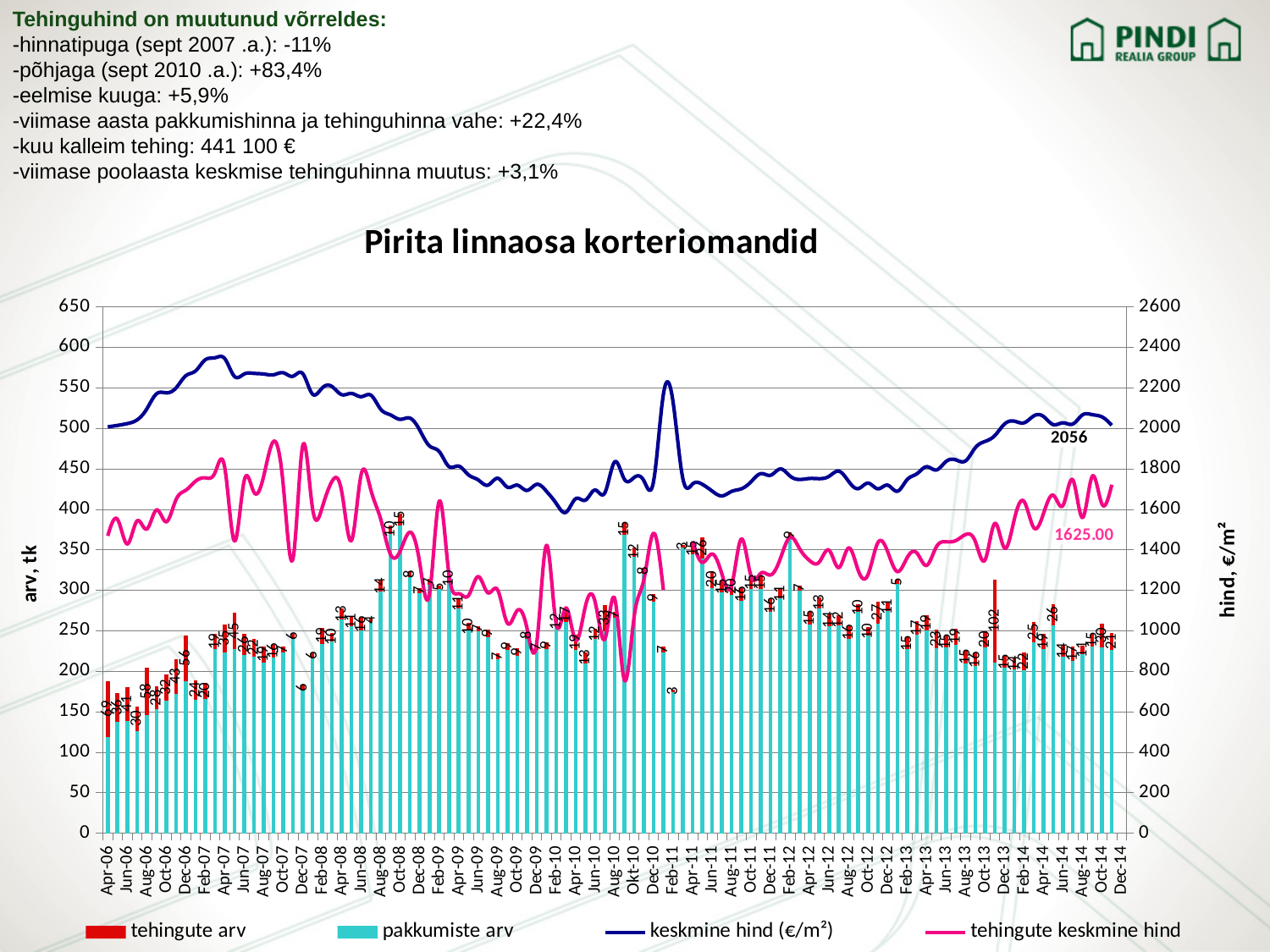
Is the keskmine hind (€/m²) value around Feb-07 greater or less than 2200? greater What is the last labelled value of the tehingute keskmine hind line? 1625.00 Is the tehingute keskmine hind value at its dip around Okt-10 greater or less than 1000? less How many series does the chart legend list? 4 What is the difference between the labelled end values of keskmine hind (2056) and tehingute keskmine hind (1625.00)? 431 What kind of chart is this? Combined bar and line chart At the end of the chart, which is higher: keskmine hind (€/m²) or tehingute keskmine hind? keskmine hind (€/m²) Is the pakkumiste arv bar at Apr-06 greater or less than 200? less Does the keskmine hind (€/m²) line rise or fall from Apr-06 to Feb-07? rise What is the label of the right-hand vertical axis? hind, €/m² What is the title of the chart? Pirita linnaosa korteriomandid What is the last labelled value of the keskmine hind (€/m²) line? 2056